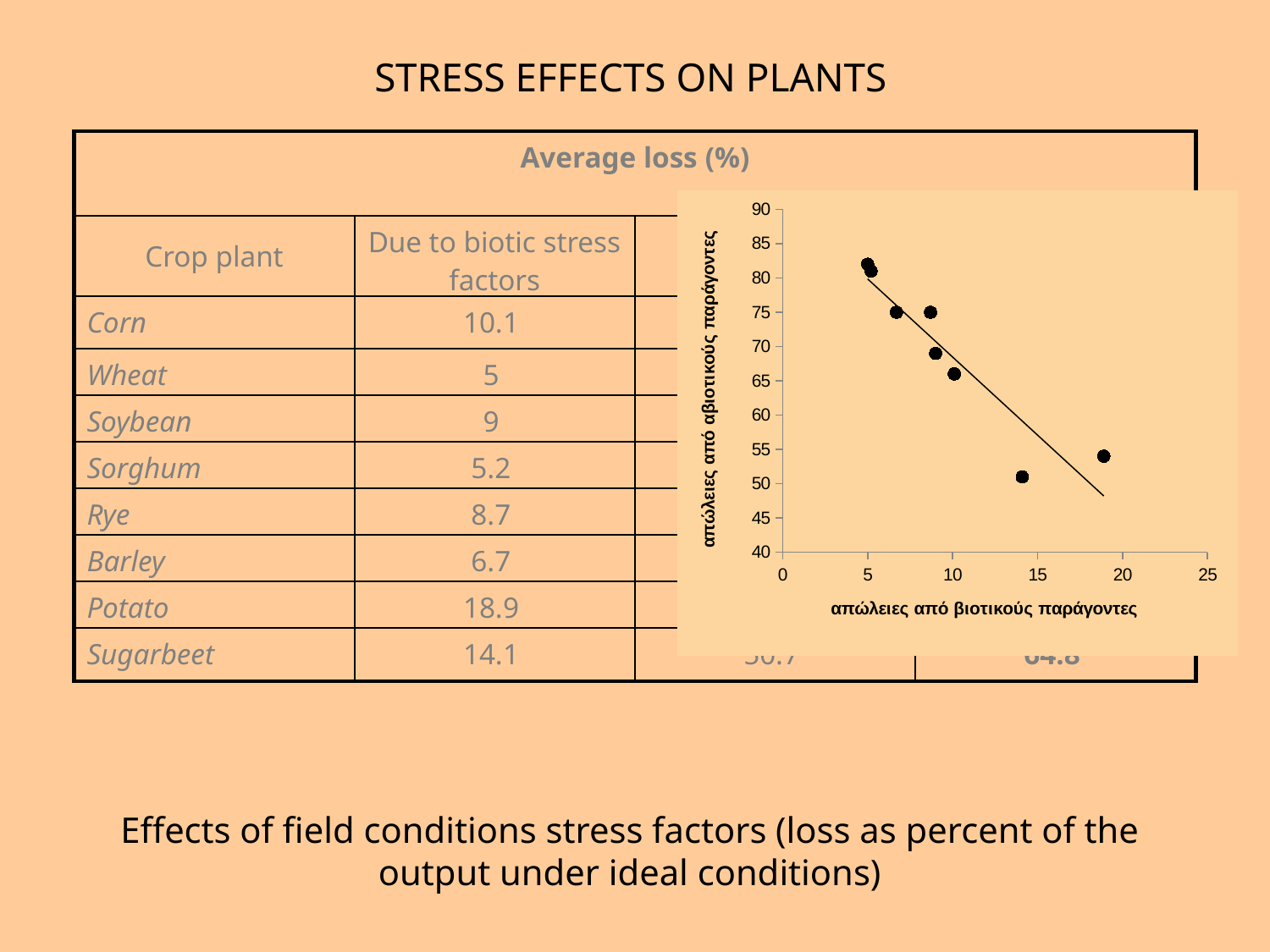
Is the y value of the points plotted at about 5 on the x axis greater or less than 75? greater What kind of chart is shown on the slide? scatter chart Is the y value of the point plotted at about 19 on the x axis greater or less than 60? less Does the fitted line in the chart slope upward or downward? downward Which point has the highest y value: the one at about 5 on the x axis or the one at about 14 on the x axis? the one at about 5 Do the plotted points generally rise or fall as the x-axis value increases? fall What is the highest value shown on the x axis? 25 Is the y value of the point plotted at about 14 on the x axis greater or less than 55? less What is the highest value shown on the y axis? 90